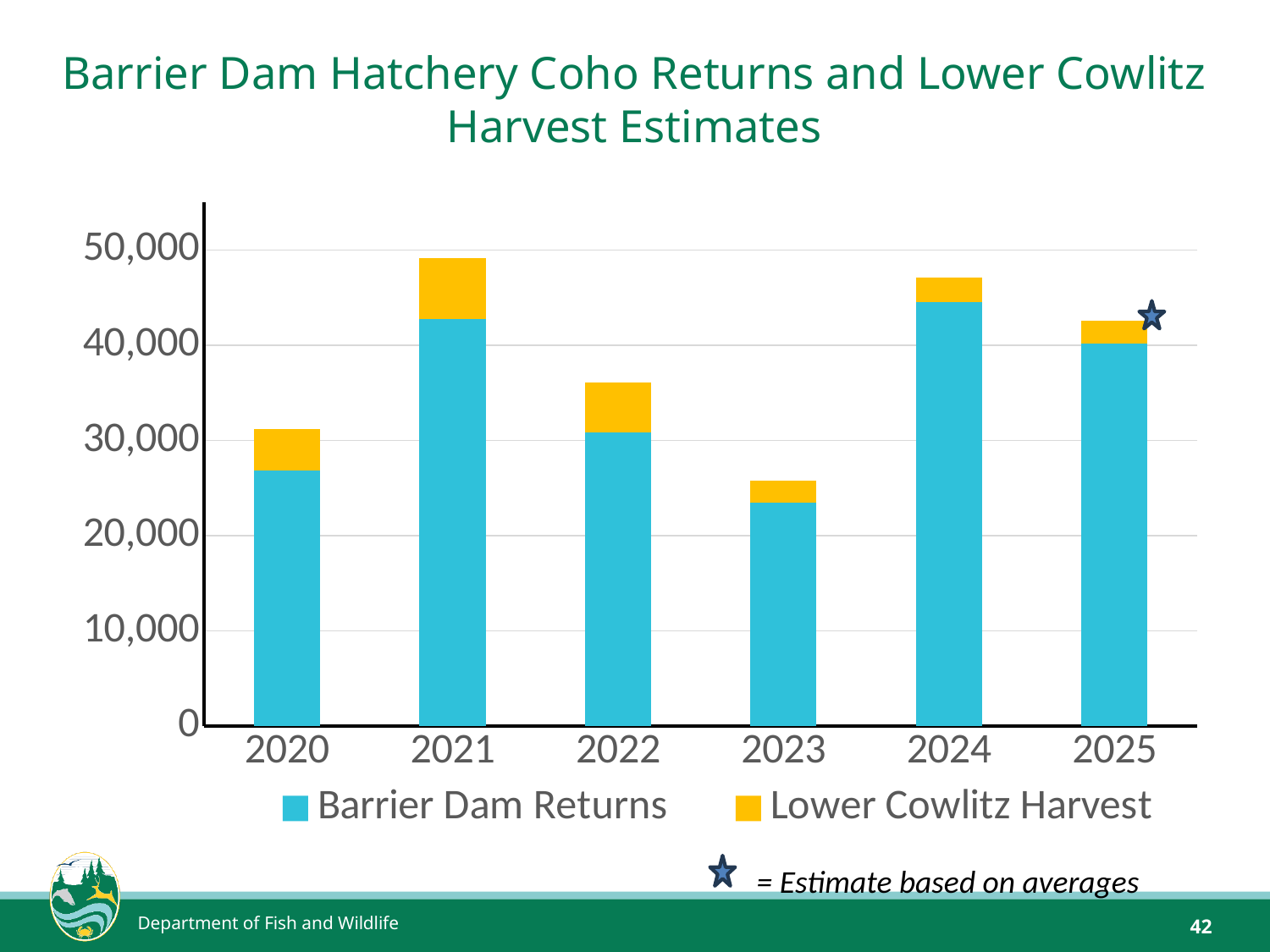
How many series does the chart's legend list? 2 Which year has the highest Barrier Dam Returns? 2024 Which year has the shortest stacked bar (lowest combined returns and harvest)? 2023 Is the Barrier Dam Returns value for 2024 greater or less than 40,000? greater How many years are shown on the x axis of the chart? 6 Which year has the larger Lower Cowlitz Harvest segment, 2021 or 2023? 2021 Which year has the tallest stacked bar (highest combined returns and harvest)? 2021 Which year has the lowest Barrier Dam Returns? 2023 Is the total stacked bar for 2021 greater or less than 50,000? less According to the note on the slide, what does the star next to the 2025 bar indicate? Estimate based on averages Is the total stacked bar for 2023 greater or less than 30,000? less What kind of chart is shown on the slide? Stacked bar chart